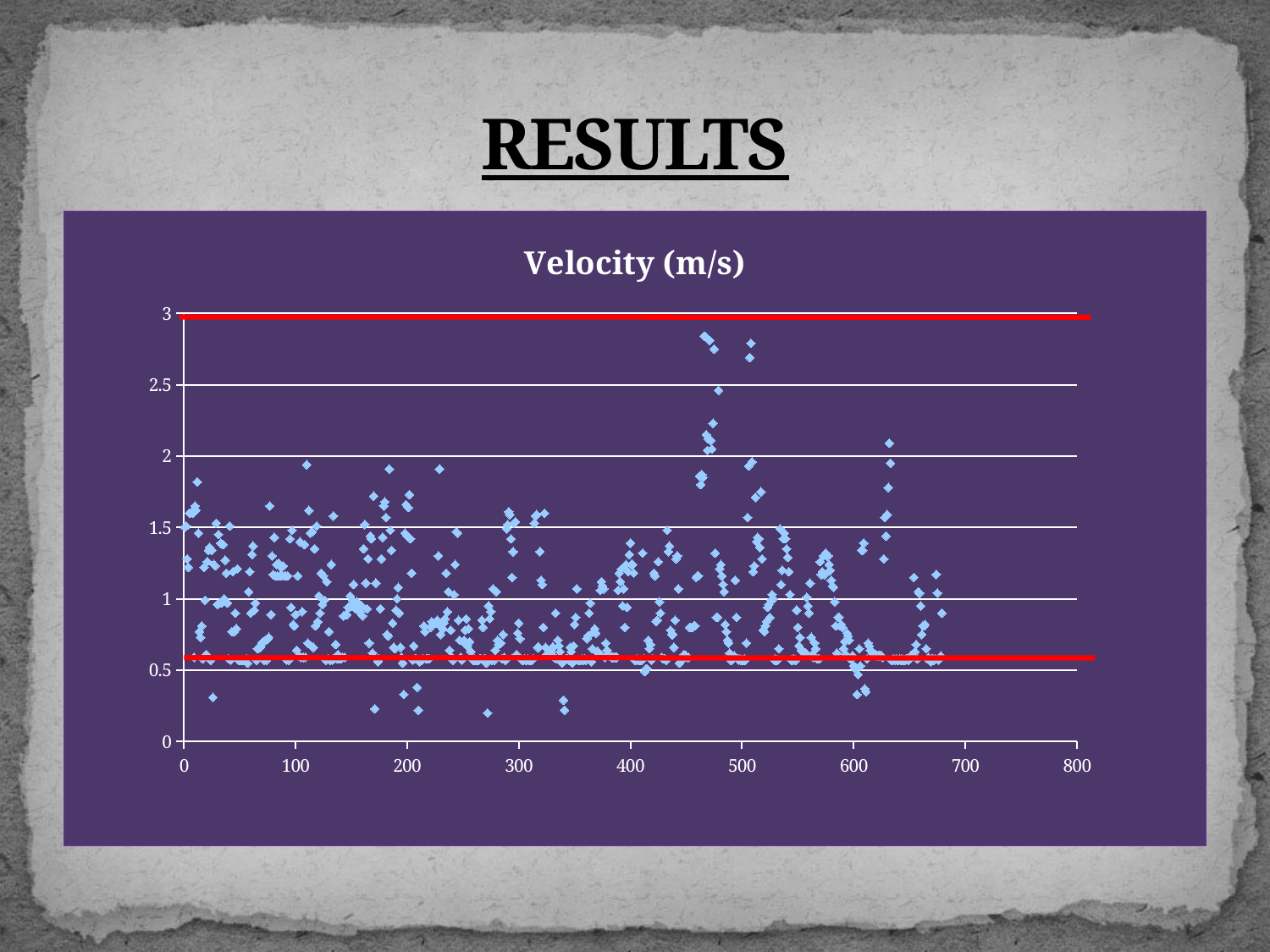
Is the upper red horizontal line greater or less than 2.5? greater What kind of chart is shown on the slide? scatter chart How many red horizontal lines are drawn on the chart? 2 What is the highest value shown on the y axis? 3 Is the highest plotted point on the chart greater or less than 2.5? greater What is the title of the chart? Velocity (m/s) Is the lower red horizontal line greater or less than 1? less